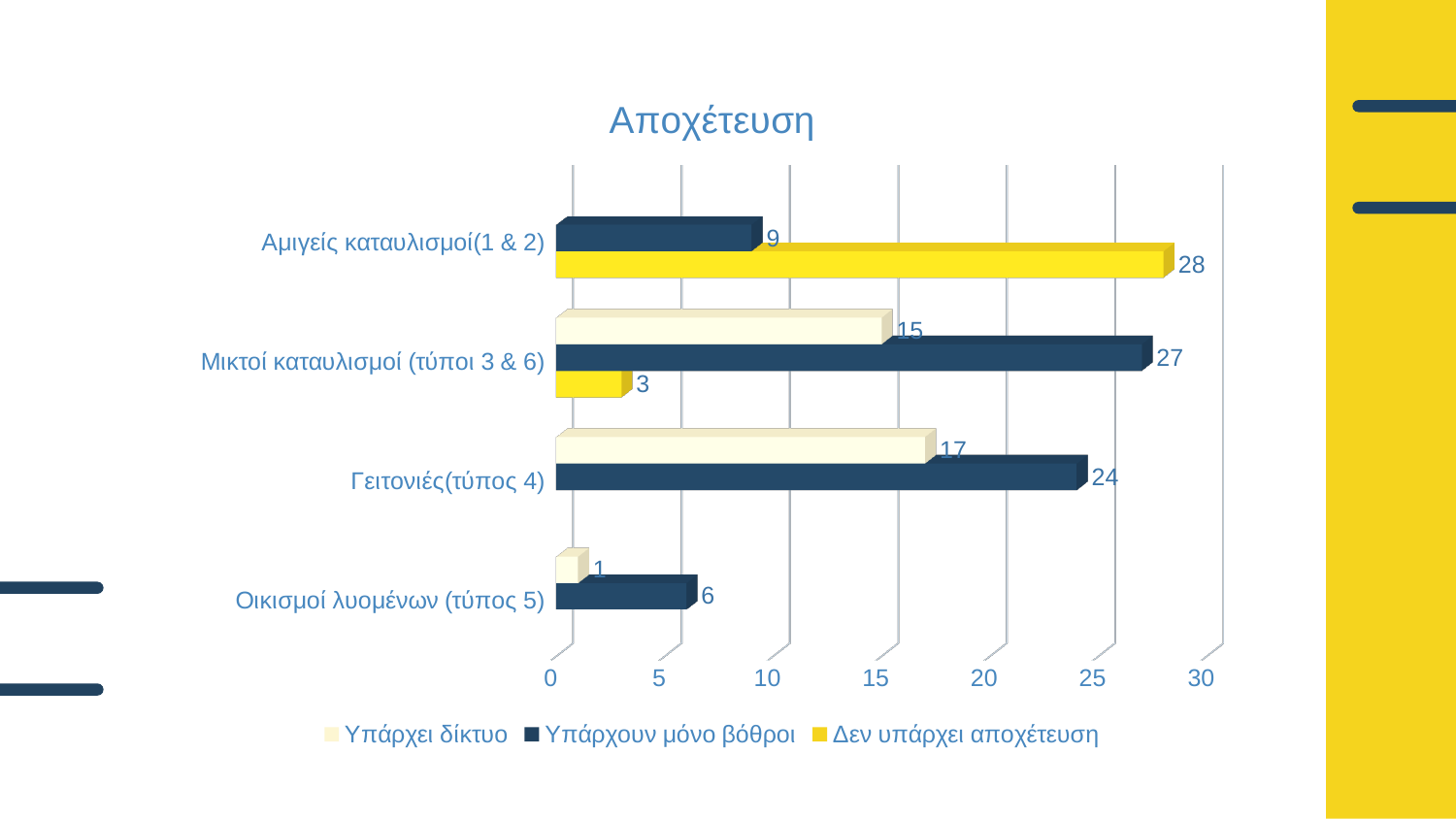
Which category has the highest value for 'Υπάρχουν μόνο βόθροι'? Μικτοί καταυλισμοί (τύποι 3 & 6) What is the value of 'Υπάρχει δίκτυο' for 'Γειτονιές(τύπος 4)'? 17 How many series does the legend list? 3 How many categories are shown on the vertical axis? 4 What is the value of 'Υπάρχουν μόνο βόθροι' for 'Οικισμοί λυομένων (τύπος 5)'? 6 What is the difference between 'Υπάρχουν μόνο βόθροι' and 'Υπάρχει δίκτυο' for 'Γειτονιές(τύπος 4)'? 7 What is the value of 'Υπάρχουν μόνο βόθροι' for 'Μικτοί καταυλισμοί (τύποι 3 & 6)'? 27 For 'Μικτοί καταυλισμοί (τύποι 3 & 6)', which is larger: 'Υπάρχει δίκτυο' or 'Δεν υπάρχει αποχέτευση'? Υπάρχει δίκτυο Which category has the lowest value for 'Υπάρχει δίκτυο'? Οικισμοί λυομένων (τύπος 5) What type of chart is shown on the slide? Bar chart What is the value of 'Δεν υπάρχει αποχέτευση' for 'Αμιγείς καταυλισμοί(1 & 2)'? 28 What is the title of the chart? Αποχέτευση